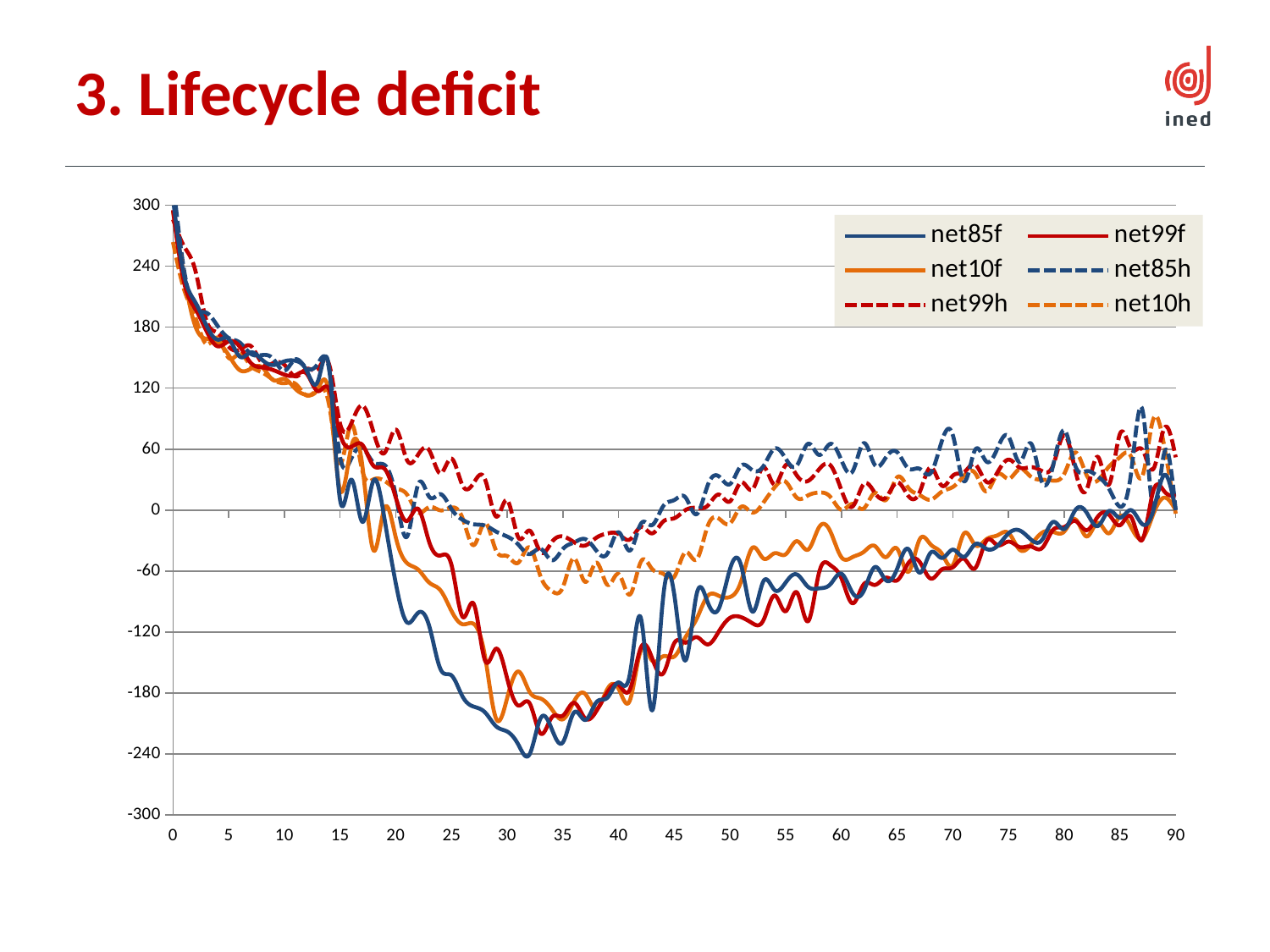
Is the value of net85f at age 30 greater or less than -180? less Is the value of net10h at age 35 greater or less than 0? less Is the value of net99f at age 0 greater or less than 240? greater Do the values of net99f rise or fall between age 40 and age 90? rise Do the values of net85f rise or fall between age 0 and age 30? fall Which series reaches the lowest value on the chart? net85f What is the title of the slide containing the chart? 3. Lifecycle deficit What kind of chart is shown on the slide? line chart How many series does the legend list? 6 Which series are drawn with dashed lines? net85h, net99h, net10h At age 30, which is larger: net85f or net85h? net85h